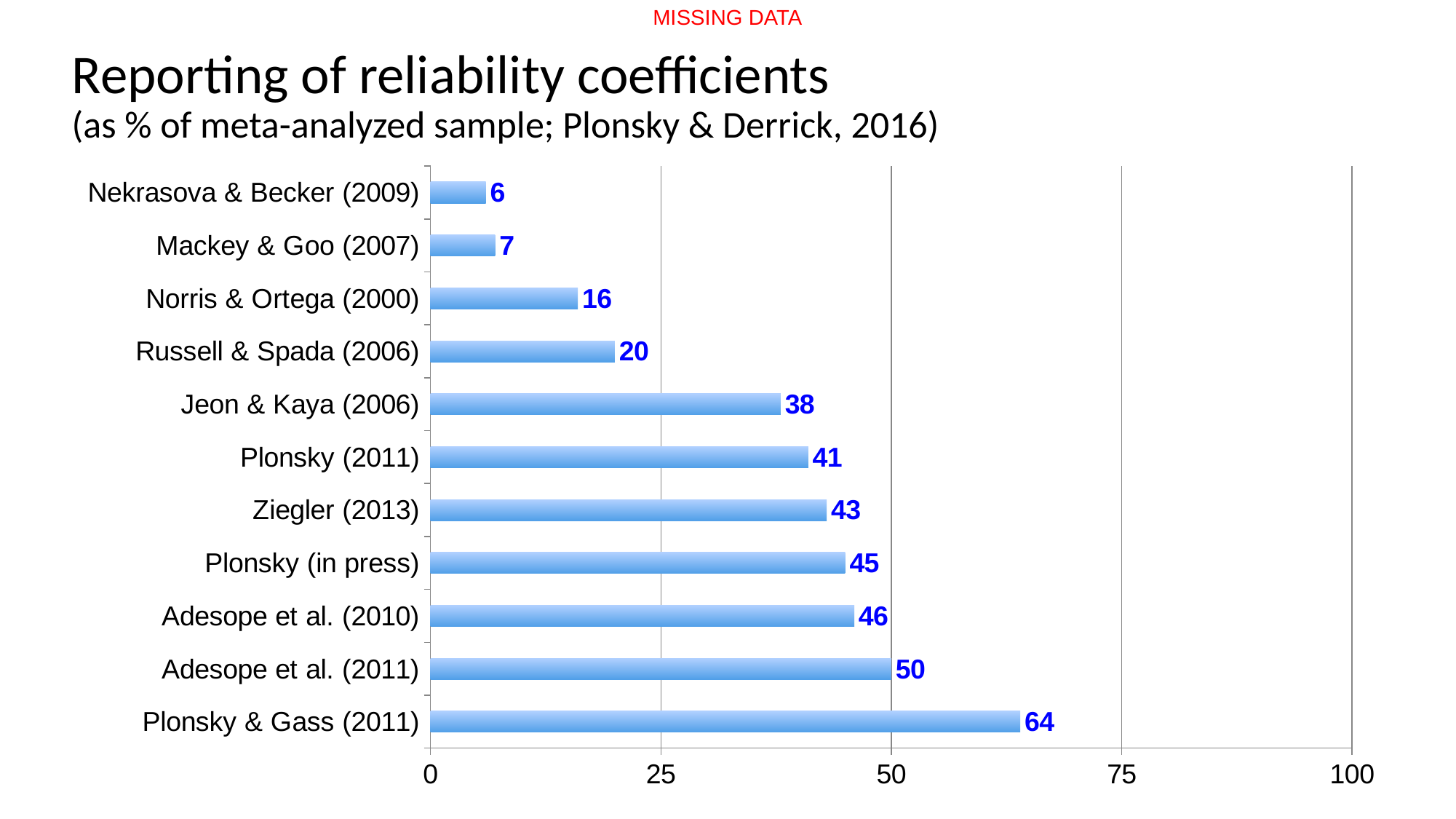
Which is larger, the value for Plonsky (2011) or the value for Jeon & Kaya (2006)? Plonsky (2011) What is the difference between the values for Jeon & Kaya (2006) and Russell & Spada (2006)? 18 Is the value for Adesope et al. (2010) greater or less than 50? less What is the difference between the values for Plonsky & Gass (2011) and Adesope et al. (2011)? 14 What is the value for Norris & Ortega (2000)? 16 What is the value for Plonsky & Gass (2011)? 64 What is the value for Ziegler (2013)? 43 Which category has the lowest value? Nekrasova & Becker (2009) Which category has the highest value? Plonsky & Gass (2011) How many categories are shown in the chart? 11 What kind of chart is shown on the slide? bar chart What is the title of the chart? Reporting of reliability coefficients